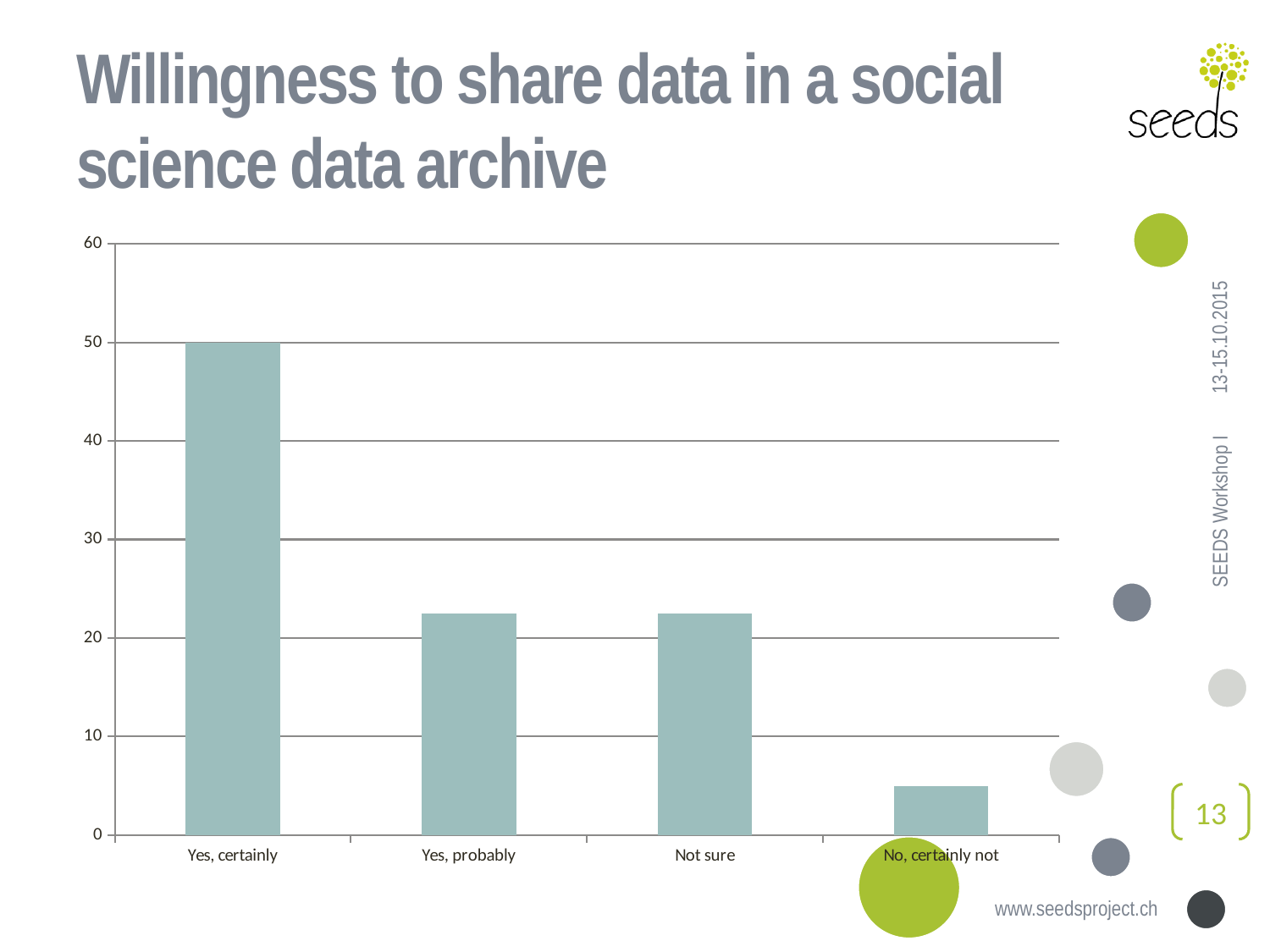
Is the value for "Not sure" greater or less than 30? less What type of chart is shown on the slide? bar chart Is the value for "No, certainly not" greater or less than 10? less What is the title of the chart on the slide? Willingness to share data in a social science data archive Which is larger, the value for "Yes, certainly" or the value for "Not sure"? Yes, certainly Which is larger, the value for "Yes, probably" or the value for "No, certainly not"? Yes, probably Do the values generally rise or fall from left to right along the x axis? fall Which category has the lowest value? No, certainly not Which category has the highest value? Yes, certainly Is the value for "Yes, probably" greater or less than 20? greater What is the value for "Yes, certainly"? 50 How many categories are shown on the x axis of the chart? 4